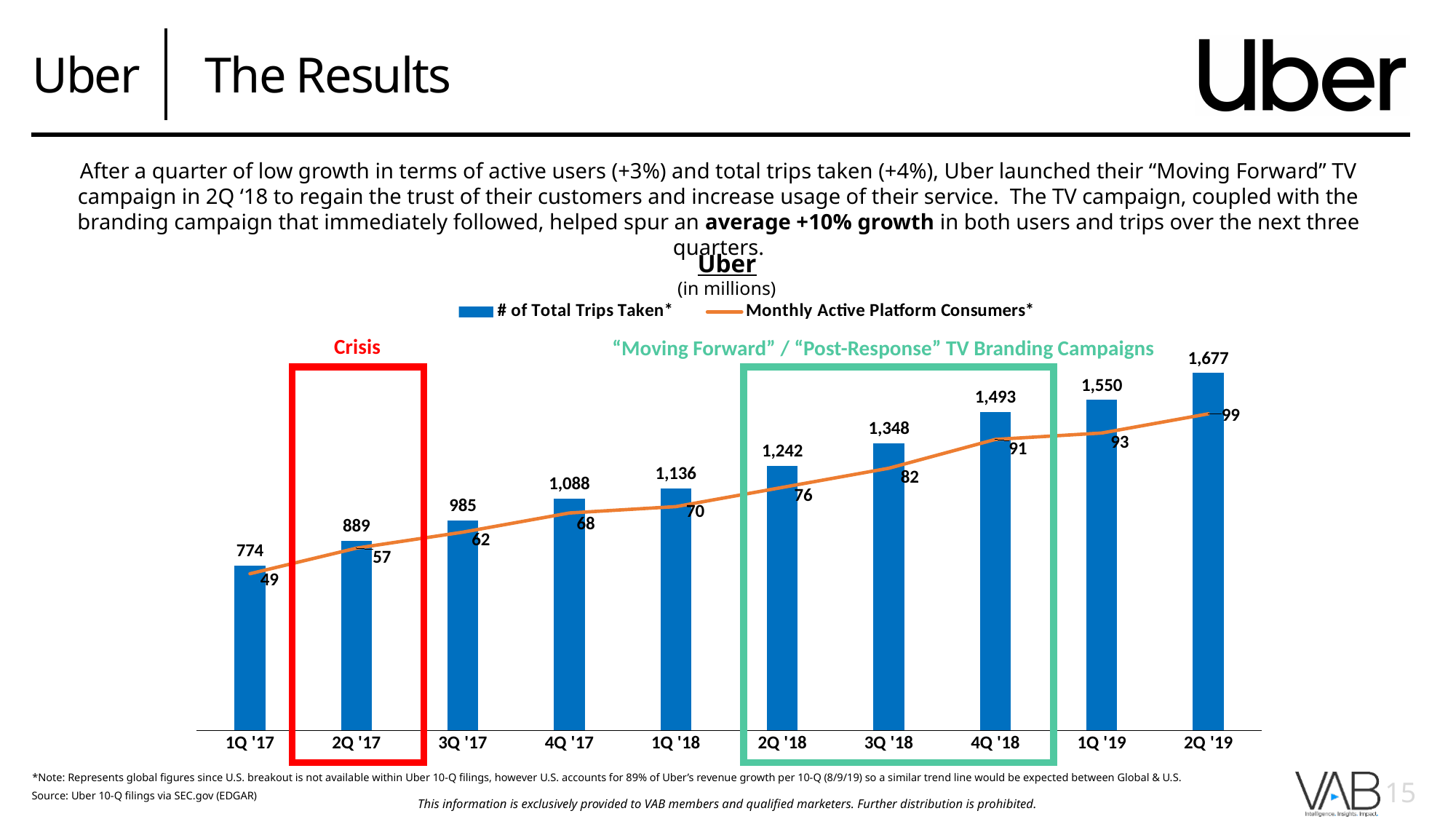
Which is larger, the # of Total Trips Taken in 3Q '17 or in 4Q '17? 4Q '17 Which quarter has the lowest Monthly Active Platform Consumers value? 1Q '17 What is the difference in # of Total Trips Taken between 2Q '19 and 1Q '19? 127 What is the difference in Monthly Active Platform Consumers between 3Q '18 and 2Q '18? 6 What is the value of # of Total Trips Taken for 1Q '17? 774 How many quarters are shown on the x axis of the chart? 10 Which quarter has the highest # of Total Trips Taken? 2Q '19 Do the Monthly Active Platform Consumers values rise or fall from 1Q '17 to 2Q '19? Rise What is the value of Monthly Active Platform Consumers for 4Q '18? 91 What is the value of # of Total Trips Taken for 2Q '18? 1,242 How many series does the chart legend list? 2 What kind of chart is used to show # of Total Trips Taken? Bar chart